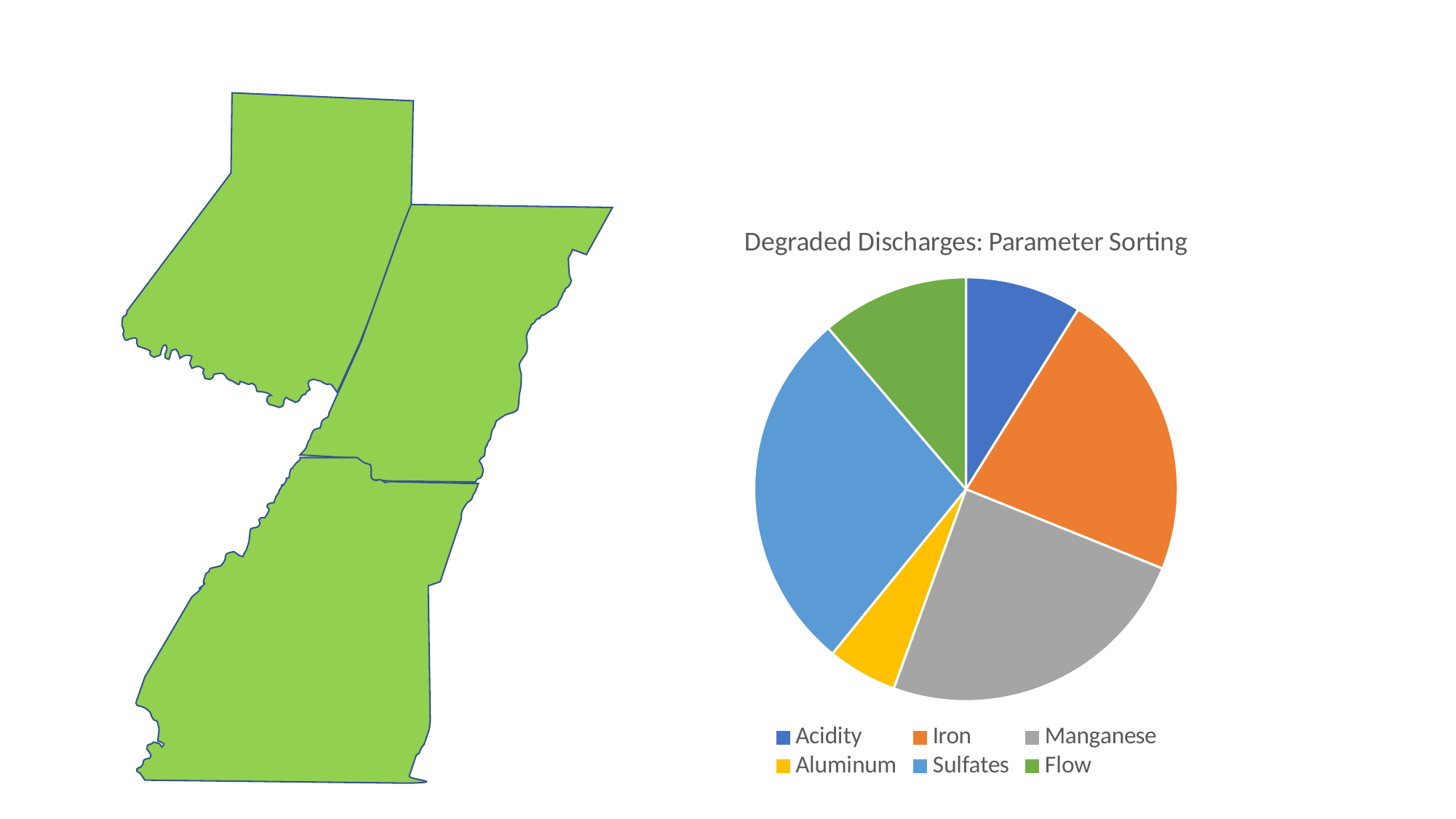
Which slice is larger in the pie chart, Flow or Acidity? Flow What is the title of the pie chart? Degraded Discharges: Parameter Sorting What kind of chart is shown on the right side of the slide? Pie chart Which category has the smallest slice in the pie chart? Aluminum Which slice is larger in the pie chart, Sulfates or Aluminum? Sulfates How many slices does the pie chart have? 6 Which slice is larger in the pie chart, Manganese or Flow? Manganese How many entries does the legend of the pie chart list? 6 What colour is the Flow slice in the pie chart? Green